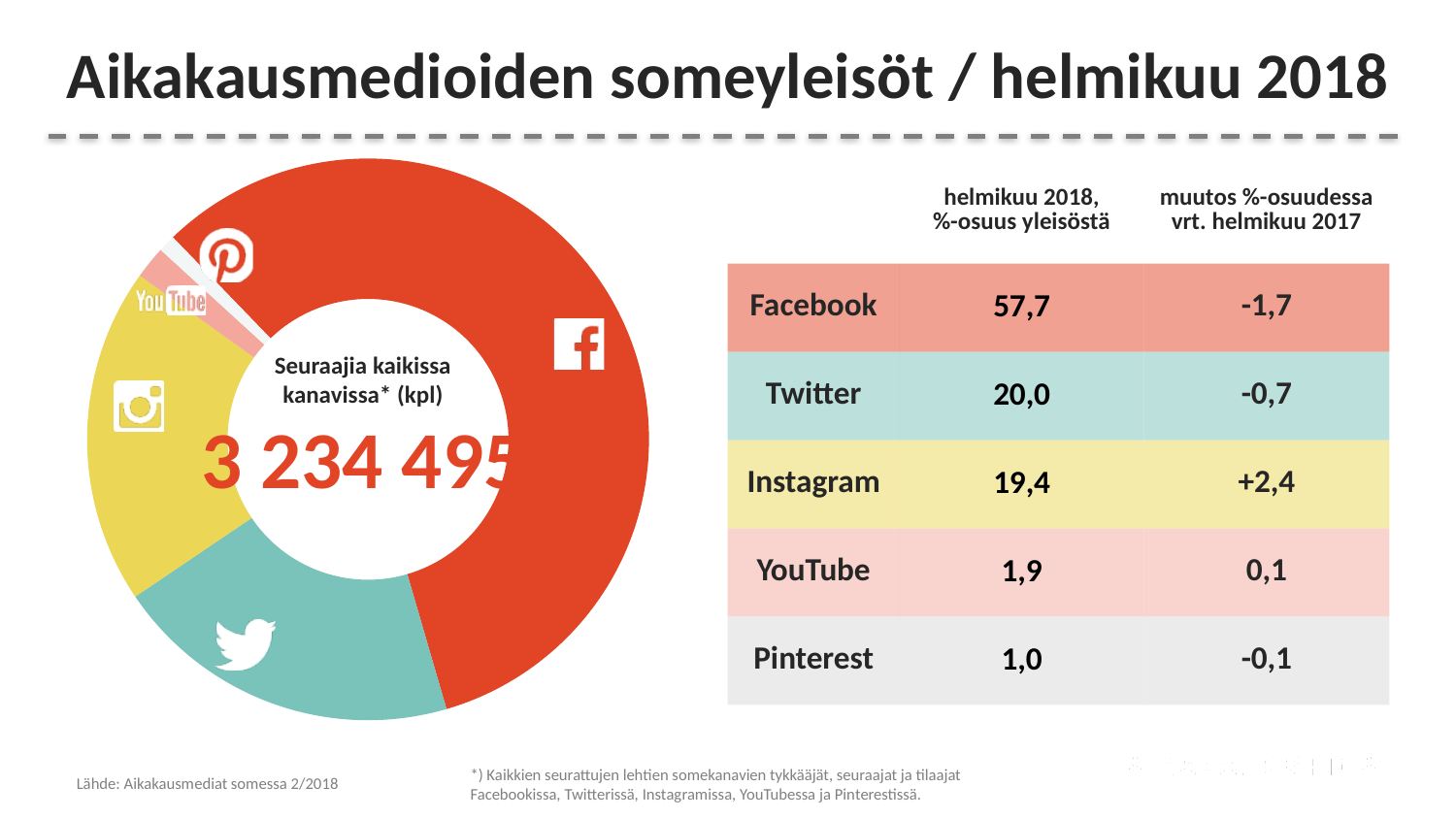
What kind of chart is shown on the left of the slide? Donut (pie) chart Which channel has the largest share of the audience? Facebook What is the change in percentage share for Instagram compared with February 2017? +2,4 Which has a larger share of the audience, Twitter or YouTube? Twitter What total number of followers across all channels is printed in the centre of the donut chart? 3 234 495 Which channel's share increased the most compared with February 2017? Instagram What is Facebook's share of the audience in February 2018 according to the table? 57,7 Which channel has the smallest share of the audience? Pinterest What is the change in percentage share for Facebook compared with February 2017? -1,7 What is the difference in percentage share between Twitter and Instagram in February 2018? 0,6 How many channels are shown in the donut chart and table? 5 What is Instagram's share of the audience in February 2018? 19,4